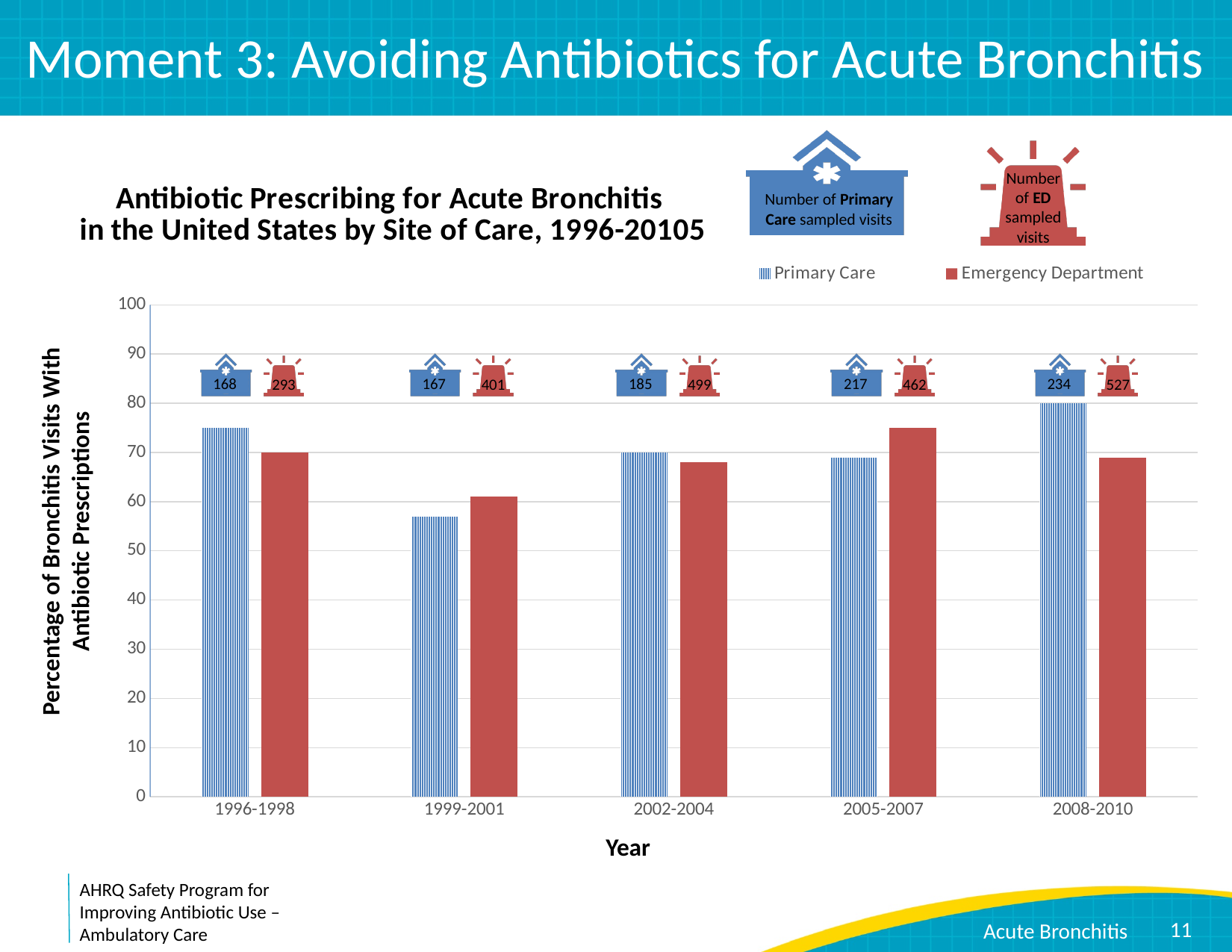
In 1996-1998, which is larger: the Primary Care or the Emergency Department percentage? Primary Care In 2005-2007, which is larger: the Primary Care or the Emergency Department percentage? Emergency Department What is the number of ED sampled visits shown for 2008-2010? 527 How many series does the chart legend list? 2 Which year group has the highest Emergency Department percentage? 2005-2007 Which year group has the highest Primary Care percentage? 2008-2010 Is the Primary Care value for 1999-2001 greater or less than 60? less Which year group has the lowest Primary Care percentage? 1999-2001 What type of chart is shown on the slide? Bar chart How many year groups are shown on the x axis? 5 What is the label of the x axis? Year Is the Emergency Department value for 2005-2007 greater or less than 70? greater